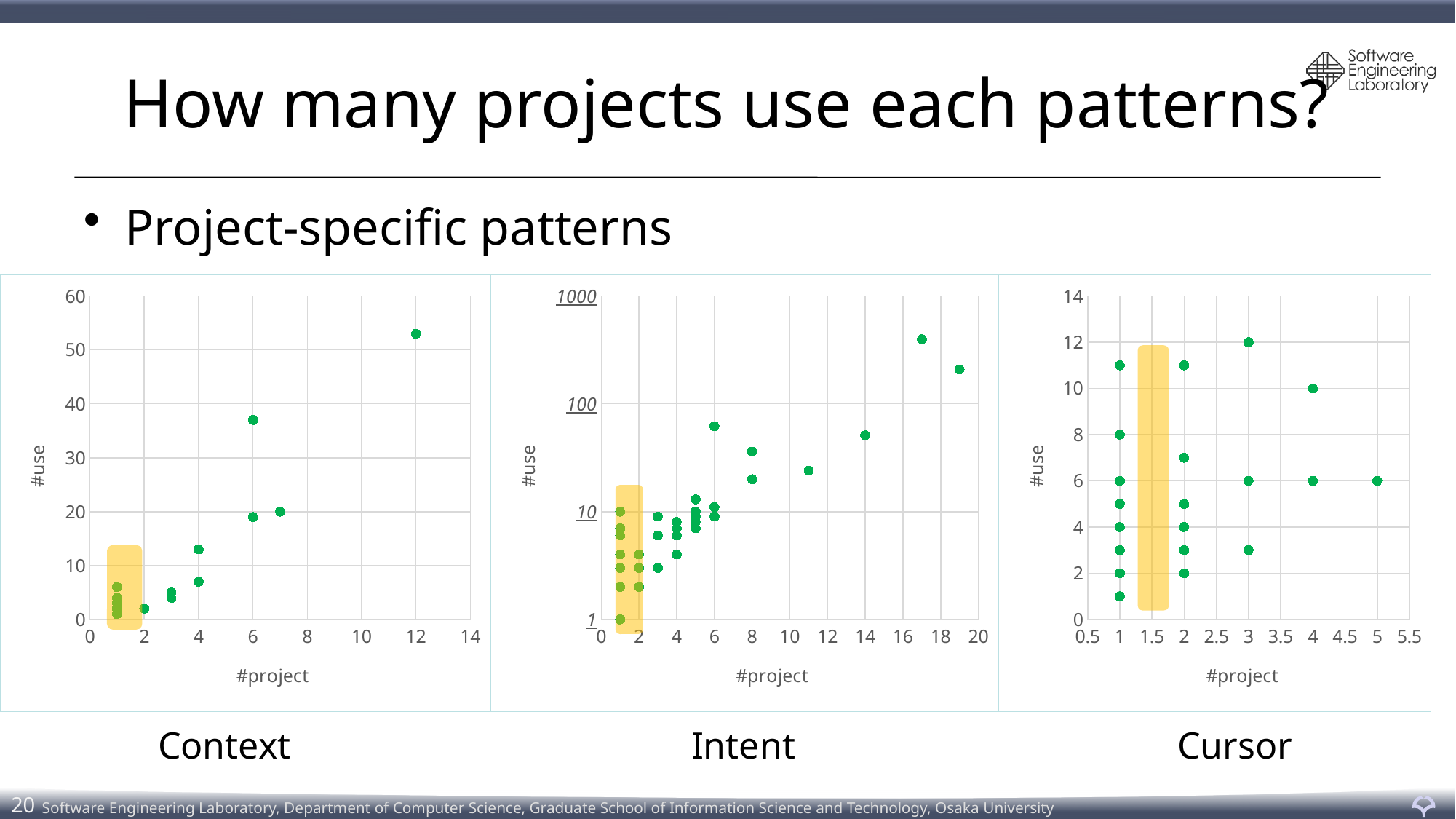
In the Context chart, at which #project value is the highest #use point plotted? 12 In the Cursor chart, what is the highest #use value plotted? 12 In the Context chart, does #use generally rise or fall as #project increases? rise In the Cursor chart, what is the #use value of the point at #project = 5? 6 What is the label of the horizontal axis on the Cursor chart? #project What is the label of the vertical axis on the Intent chart? #use In the Context chart, is the #use value for the point at #project = 12 greater or less than 50? greater In the Intent chart, is the #use value for the point at #project = 17 greater or less than 100? greater In the Intent chart, is the #use value for the point at #project = 6 greater or less than 100? less What kind of chart is the Context chart? scatter chart How many charts are shown on the slide? 3